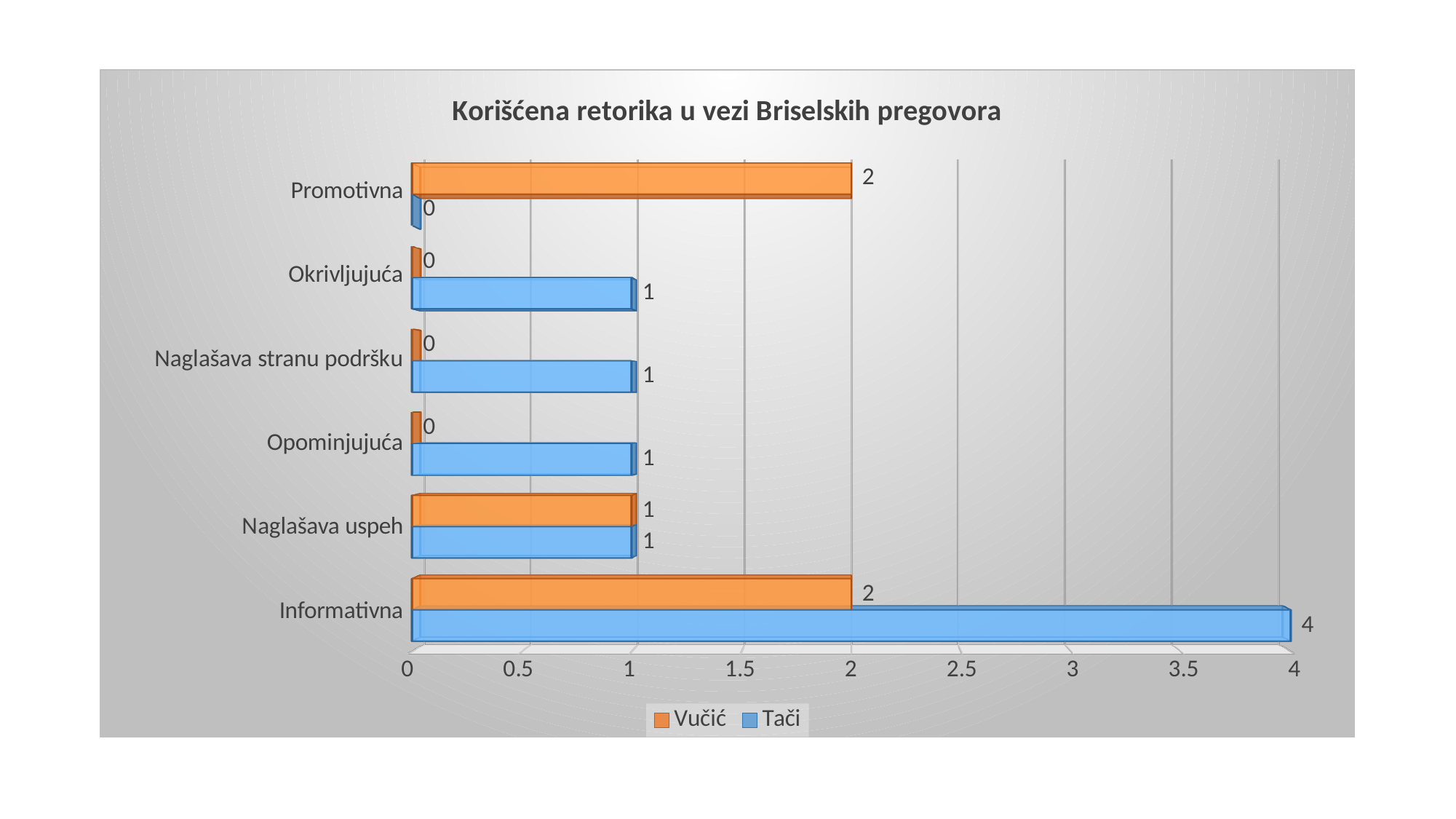
What is the value for Tači in the Okrivljujuća category? 1 What is the value for Tači in the Informativna category? 4 Which category has the highest value for Tači? Informativna In the Naglašava stranu podršku category, which is larger, the value for Vučić or for Tači? Tači What is the difference between the Tači and Vučić values in the Informativna category? 2 What is the value for Vučić in the Opominjujuća category? 0 What is the title of the chart? Korišćena retorika u vezi Briselskih pregovora How many categories are shown on the chart? 6 Which category has the lowest value for Tači? Promotivna How many series does the legend list? 2 What is the value for Vučić in the Promotivna category? 2 What kind of chart is shown on the slide? Bar chart